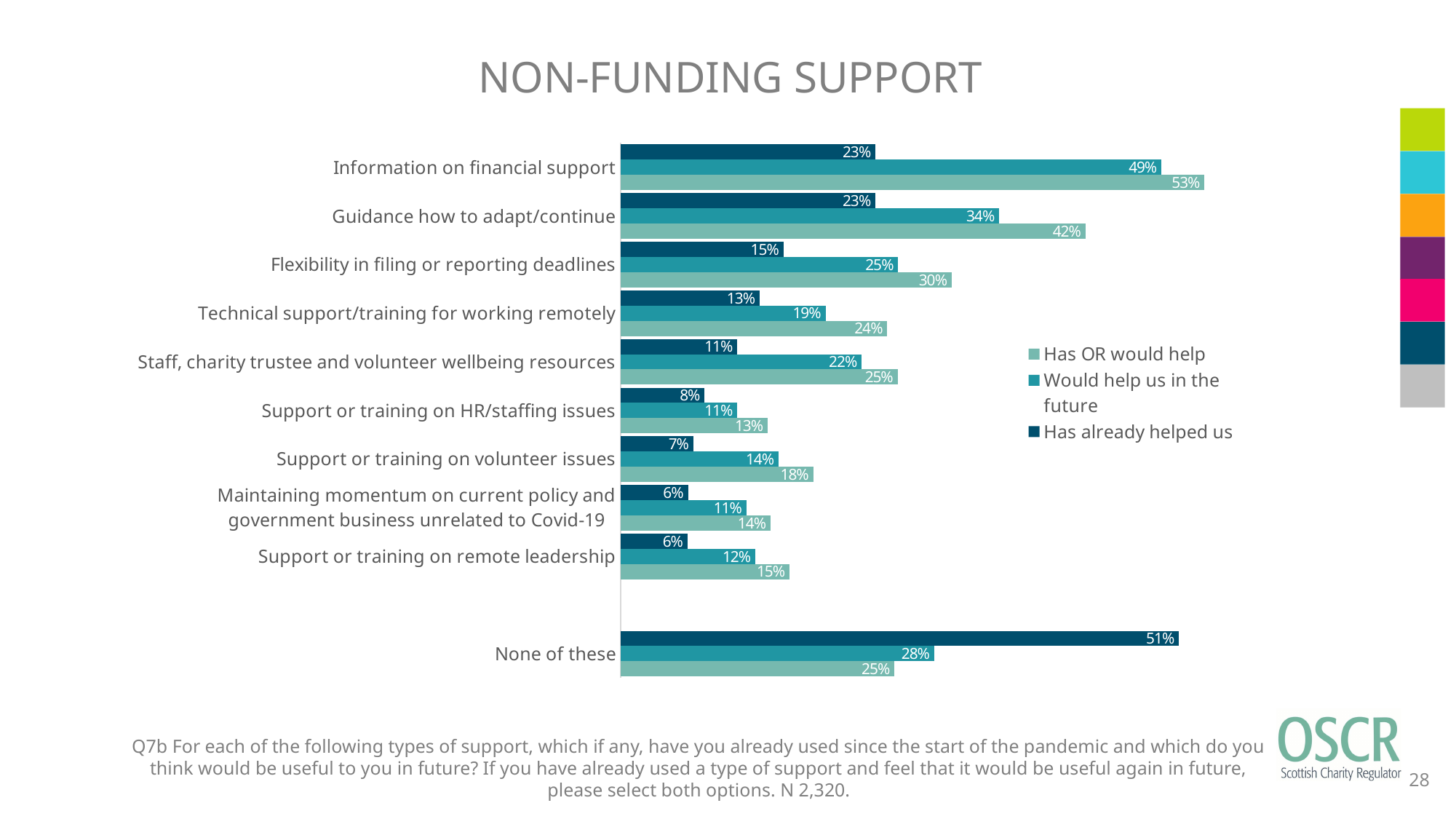
What is the title of the slide? NON-FUNDING SUPPORT Which category has the highest 'Has already helped us' value? None of these What is the difference between the 'Has OR would help' and 'Has already helped us' values for Information on financial support? 30 percentage points How many categories are shown on the chart? 10 What is the 'Has already helped us' value for Support or training on remote leadership? 6% Among the support types (excluding 'None of these'), which has the lowest 'Has OR would help' value? Support or training on HR/staffing issues Which is larger: the 'Would help us in the future' value for Flexibility in filing or reporting deadlines or for Technical support/training for working remotely? Flexibility in filing or reporting deadlines What is the 'Has already helped us' value for 'None of these'? 51% What percentage of respondents said information on financial support 'Has OR would help'? 53% How many series does the legend list? 3 What type of chart is shown on the slide? Bar chart What is the 'Would help us in the future' value for Guidance how to adapt/continue? 34%